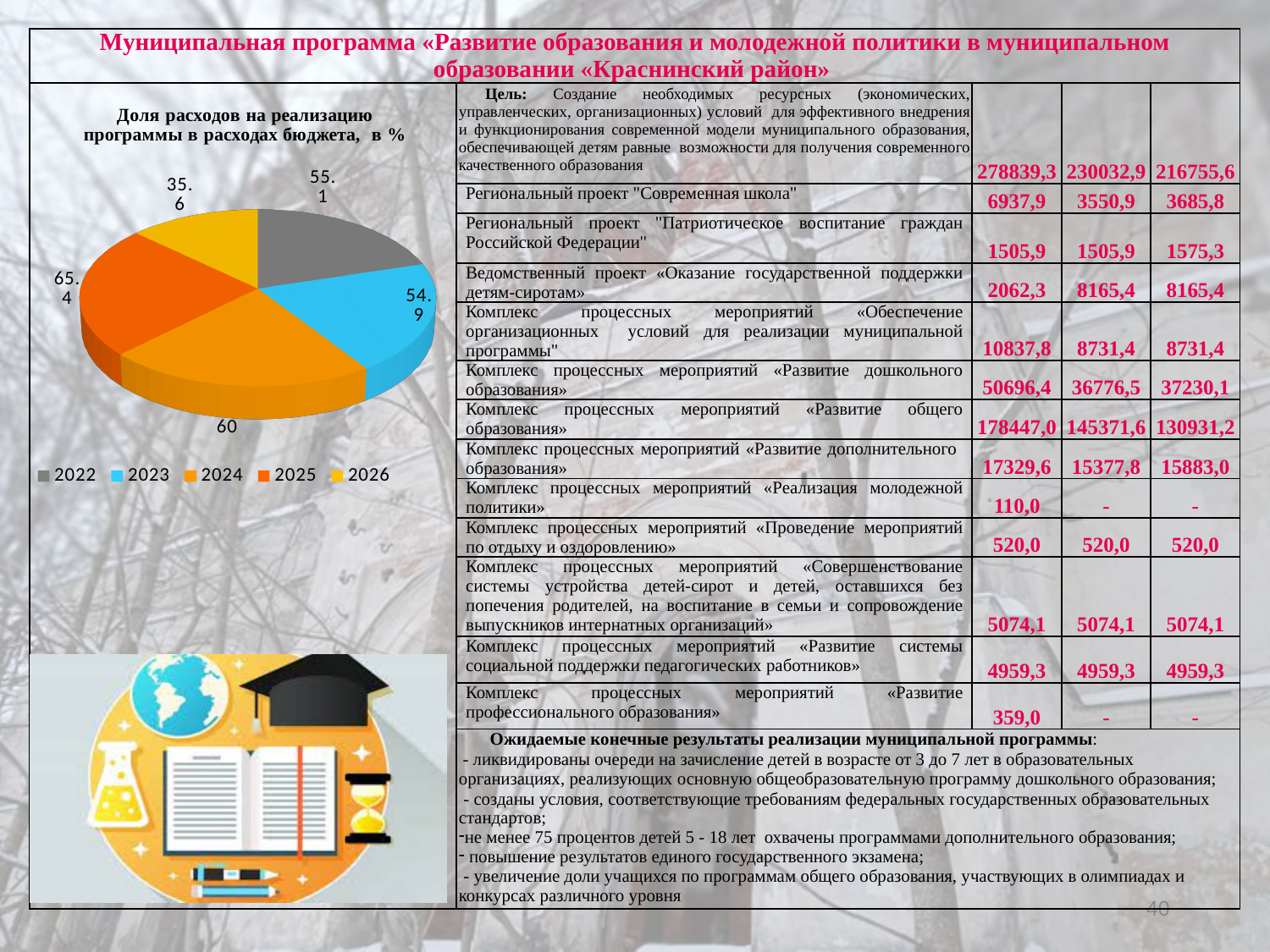
Which year has the largest value in the pie chart? 2025 In the pie chart, what is the value for 2024? 60 What colour is the slice for 2026 in the pie chart? yellow In the pie chart, what is the difference between the values for 2025 and 2026? 29.8 In the pie chart, what is the value for 2022? 55.1 In the pie chart, which is larger: the value for 2024 or the value for 2023? 2024 In the pie chart, what is the value for 2025? 65.4 How many entries does the legend of the pie chart list? 5 In the pie chart, what is the value for 2026? 35.6 Which year has the smallest value in the pie chart? 2026 What kind of chart is shown on the left of the slide under the title "Доля расходов на реализацию программы в расходах бюджета, в %"? pie chart In the pie chart, what is the value for 2023? 54.9